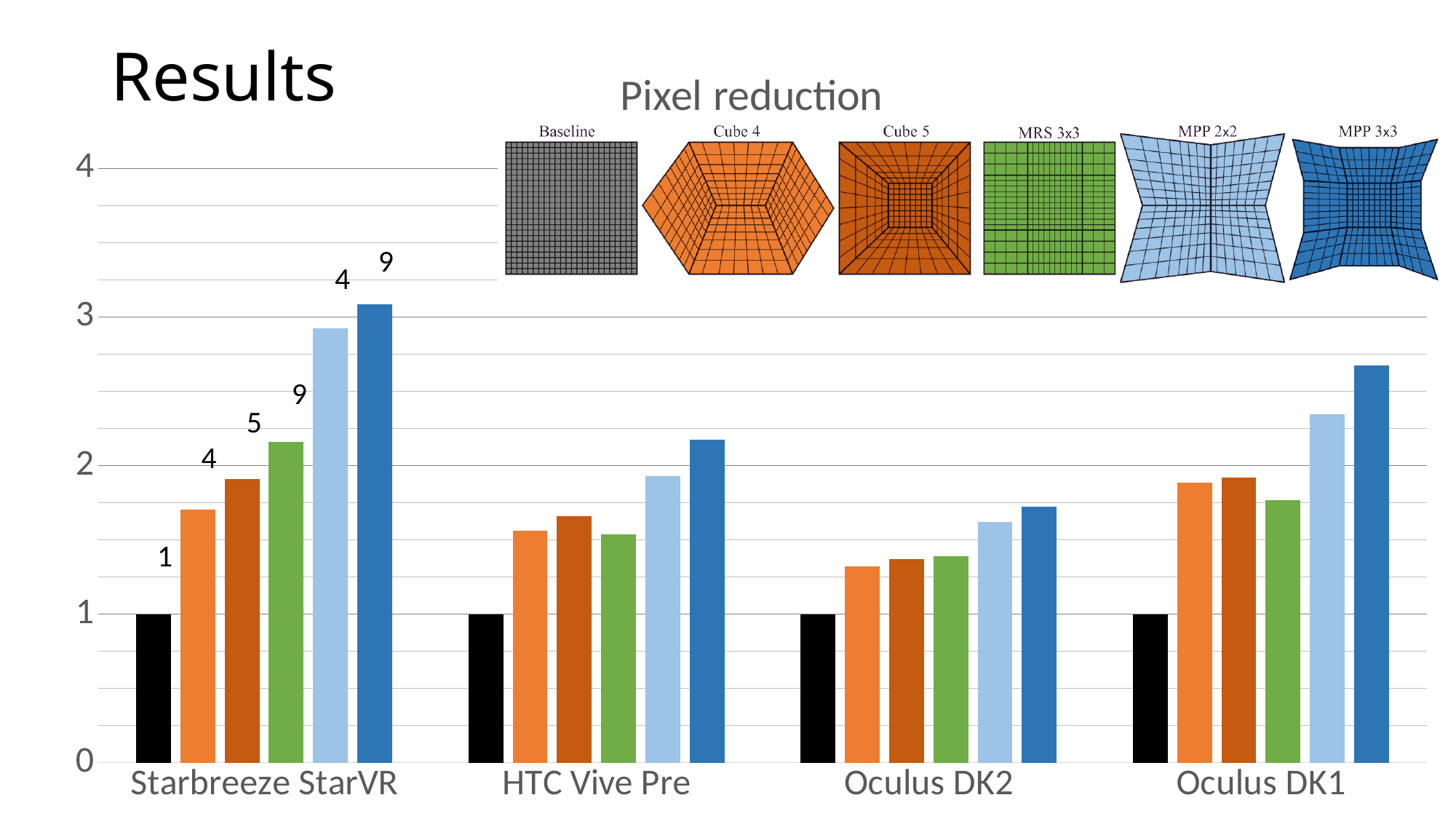
Which device has the highest MPP 3x3 bar? Starbreeze StarVR For Starbreeze StarVR, do the bars rise or fall from Baseline to MPP 3x3? rise Is the MPP 3x3 value for Oculus DK1 greater or less than 2? greater What kind of chart is shown on the slide? bar chart How many device categories are shown on the x axis of the chart? 4 How many series (rendering methods) does the chart's legend list? 6 What is the title of the chart? Pixel reduction Which series has the lowest value for Oculus DK2? Baseline Is the MPP 2x2 value for HTC Vive Pre greater or less than 2? less Which is larger for Oculus DK1: the Cube 5 value or the MRS 3x3 value? Cube 5 What is the Baseline value for HTC Vive Pre? 1 Is the MPP 3x3 value for Starbreeze StarVR greater or less than 3? greater